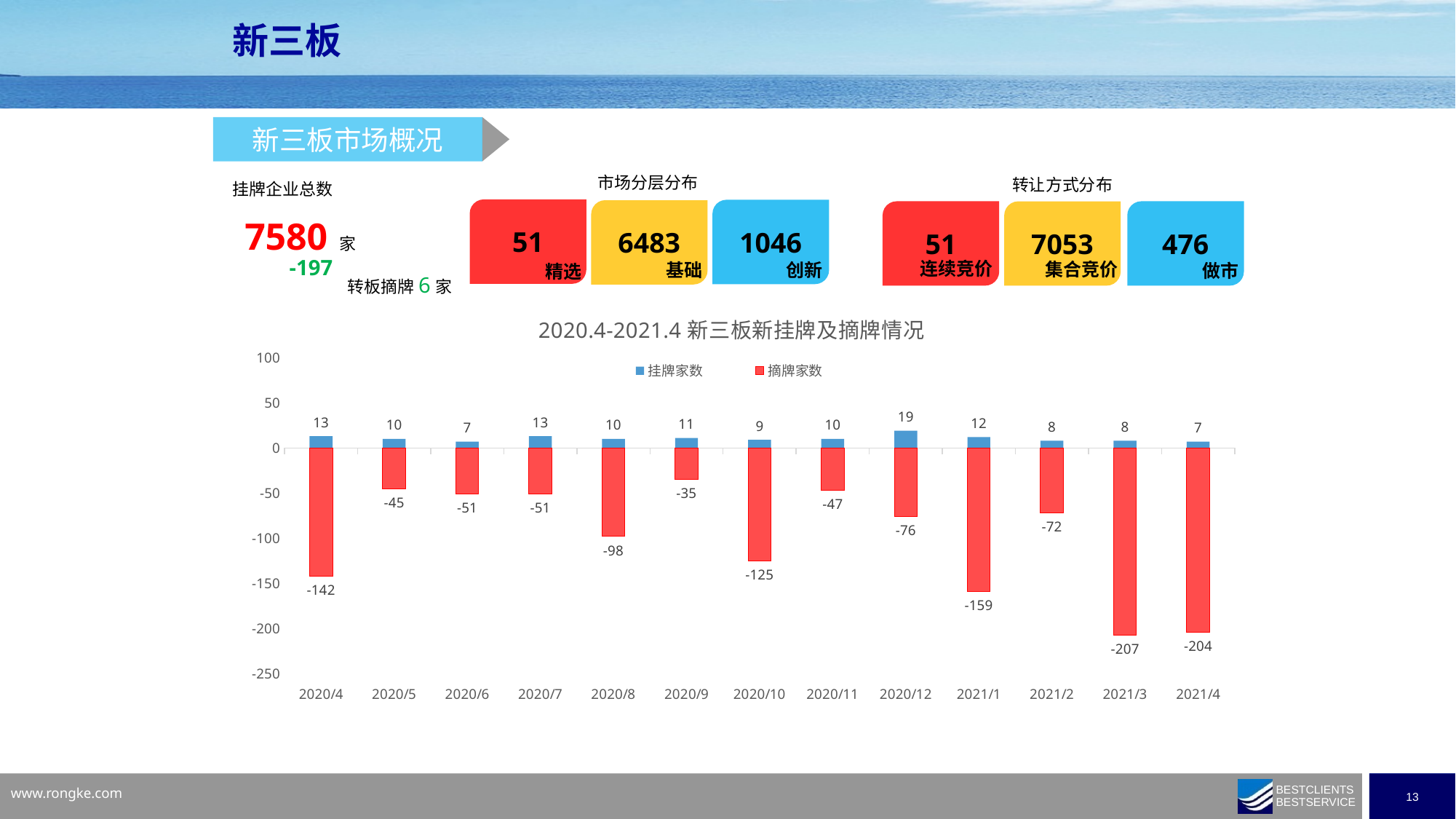
What is the 摘牌家数 value for 2020/8? -98 Which month has the highest 挂牌家数 value? 2020/12 Which month has the 摘牌家数 value closest to zero? 2020/9 Which is larger in magnitude, the 摘牌家数 for 2020/10 or for 2020/4? 2020/4 What kind of chart is used to show 新挂牌及摘牌情况? bar chart What colour represents 摘牌家数 in the chart? red Which month has the lowest 摘牌家数 value (the largest number of delistings)? 2021/3 What is the difference between the 挂牌家数 values for 2020/12 and 2021/4? 12 What is the 摘牌家数 value for 2021/3? -207 How many series does the chart legend list? 2 How many months are shown on the x axis of the chart? 13 What is the 挂牌家数 value for 2020/12? 19